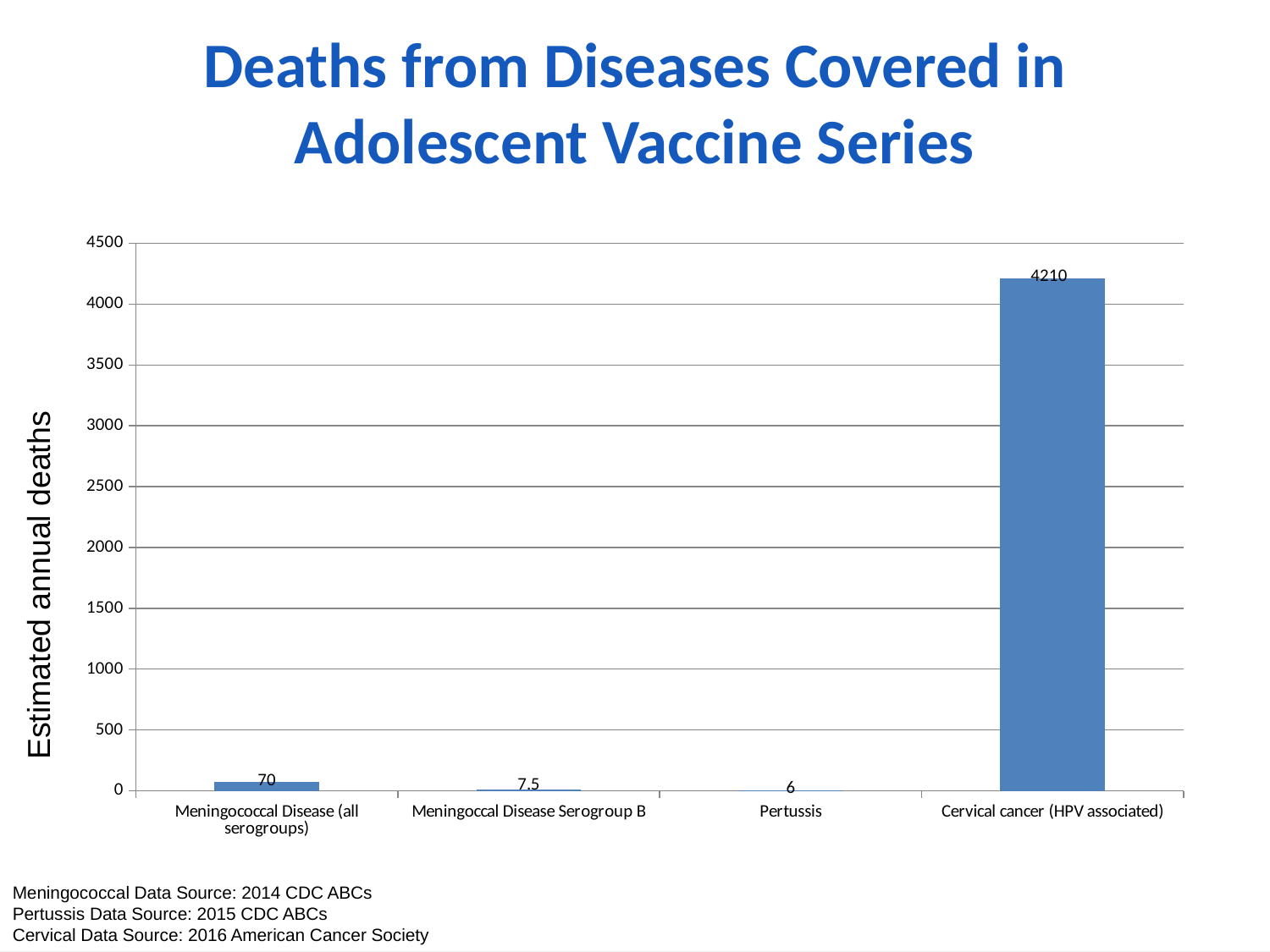
Which has more estimated annual deaths, Meningococcal Disease (all serogroups) or Pertussis? Meningococcal Disease (all serogroups) Which category has the lowest estimated annual deaths? Pertussis Is the value for Cervical cancer (HPV associated) greater or less than 4000? greater What is the difference in estimated annual deaths between Meningoccal Disease Serogroup B and Pertussis? 1.5 What is the estimated annual deaths value for Pertussis? 6 Which category has the highest estimated annual deaths? Cervical cancer (HPV associated) What is the difference in estimated annual deaths between Cervical cancer (HPV associated) and Meningococcal Disease (all serogroups)? 4140 What type of chart is shown on the slide? Bar chart How many categories are shown on the chart? 4 What is the estimated annual deaths value for Meningococcal Disease (all serogroups)? 70 What is the estimated annual deaths value for Meningoccal Disease Serogroup B? 7.5 What is the estimated annual deaths value for Cervical cancer (HPV associated)? 4210